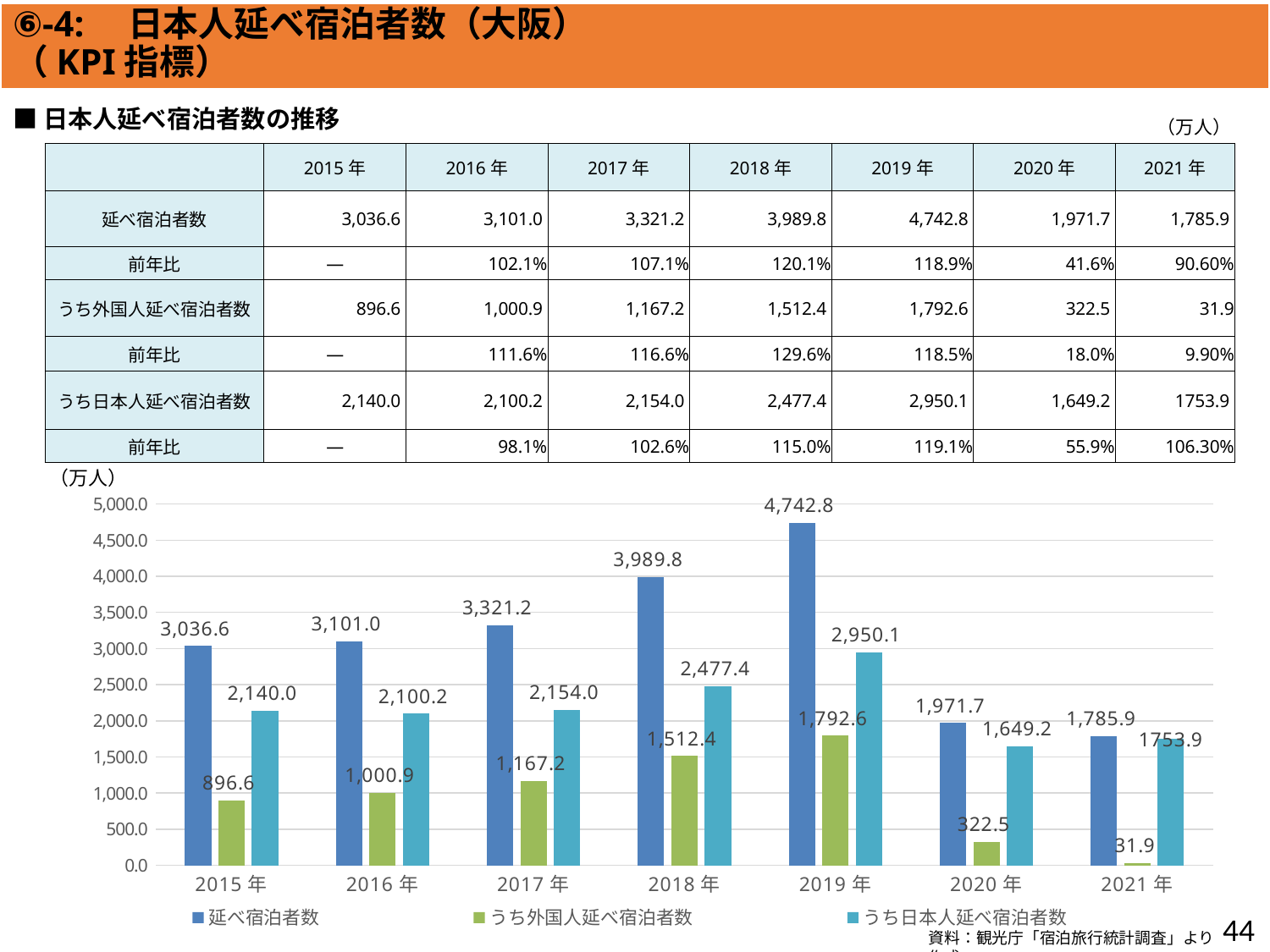
Does 延べ宿泊者数 rise or fall from 2015年 to 2019年 in the chart? Rise What is the value of うち外国人延べ宿泊者数 for 2021年 in the chart? 31.9 How many years are shown on the x axis of the chart? 7 In which year is うち外国人延べ宿泊者数 lowest in the chart? 2021年 Is the value of うち外国人延べ宿泊者数 for 2020年 greater or less than 500.0? less In which year is 延べ宿泊者数 highest in the chart? 2019年 What is the value of 延べ宿泊者数 for 2019年 in the chart? 4,742.8 What kind of chart is shown on the slide? Bar chart What is the value of うち日本人延べ宿泊者数 for 2018年 in the chart? 2,477.4 How many series does the chart legend list? 3 Which is larger in the chart: うち日本人延べ宿泊者数 in 2015年 or in 2016年? 2015年 What is the difference between 延べ宿泊者数 in 2018年 and 2017年 in the chart? 668.6